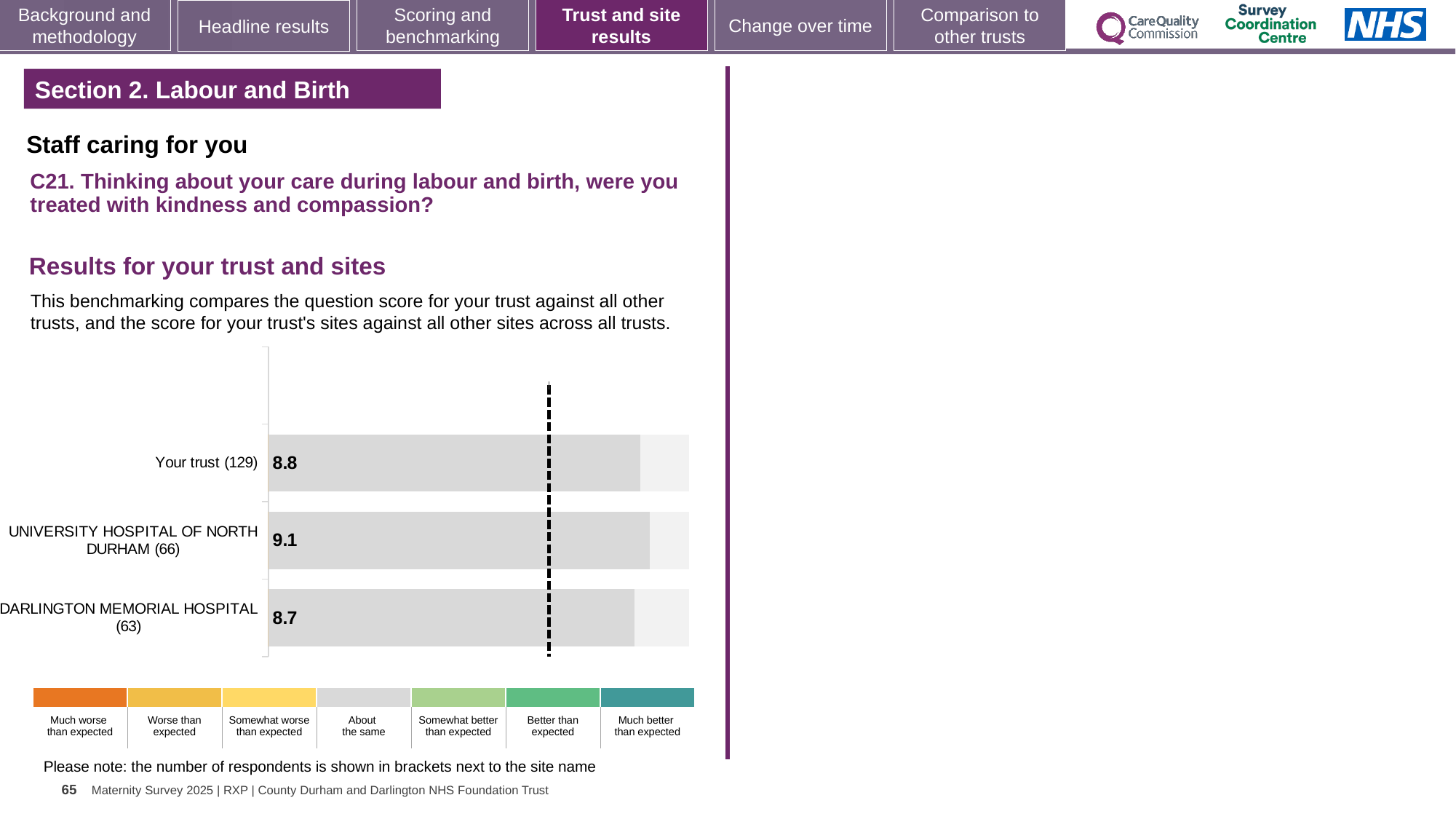
What is the difference between the scores for Your trust (129) and DARLINGTON MEMORIAL HOSPITAL (63)? 0.1 How many categories does the colour key below the chart list? 7 How many bars are plotted in the chart? 3 What is the score for DARLINGTON MEMORIAL HOSPITAL (63)? 8.7 Which site or trust has the lowest score? DARLINGTON MEMORIAL HOSPITAL (63) How many respondents are shown in brackets for DARLINGTON MEMORIAL HOSPITAL? 63 Which has a higher score, Your trust (129) or UNIVERSITY HOSPITAL OF NORTH DURHAM (66)? UNIVERSITY HOSPITAL OF NORTH DURHAM (66) What is the score for Your trust (129)? 8.8 What kind of chart is shown on the slide? Bar chart What is the difference between the scores for UNIVERSITY HOSPITAL OF NORTH DURHAM (66) and DARLINGTON MEMORIAL HOSPITAL (63)? 0.4 Which site or trust has the highest score? UNIVERSITY HOSPITAL OF NORTH DURHAM (66) What is the score for UNIVERSITY HOSPITAL OF NORTH DURHAM (66)? 9.1